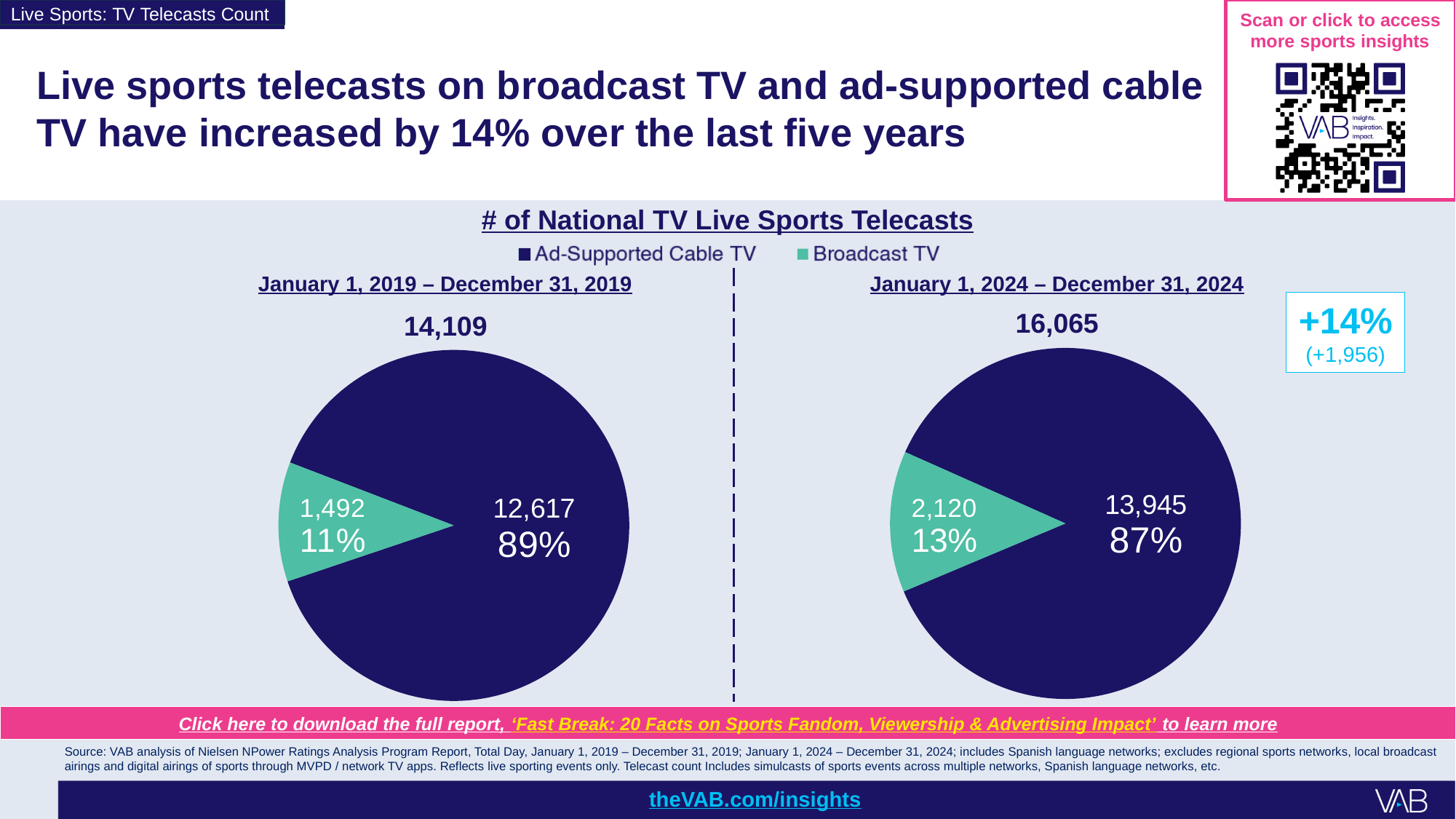
How many series does the legend list for the telecast charts? 2 What is the total number of telecasts shown above the 2024 pie chart? 16,065 In the 2019 pie chart (January 1, 2019 – December 31, 2019), how many live sports telecasts were on Ad-Supported Cable TV? 12,617 In the 2019 pie chart, which category has the larger slice? Ad-Supported Cable TV In the 2024 pie chart, which category has the smaller slice? Broadcast TV In the 2024 pie chart (January 1, 2024 – December 31, 2024), how many live sports telecasts were on Broadcast TV? 2,120 In the 2024 pie chart, what share of telecasts was Ad-Supported Cable TV? 87% What is the difference between the Broadcast TV telecast counts in the 2024 and 2019 pie charts? 628 Is the Ad-Supported Cable TV count larger in the 2019 pie chart or the 2024 pie chart? 2024 What is the total number of telecasts shown above the 2019 pie chart? 14,109 In the 2019 pie chart, what share of telecasts was Broadcast TV? 11% What type of chart is used to show the number of National TV live sports telecasts? Pie chart